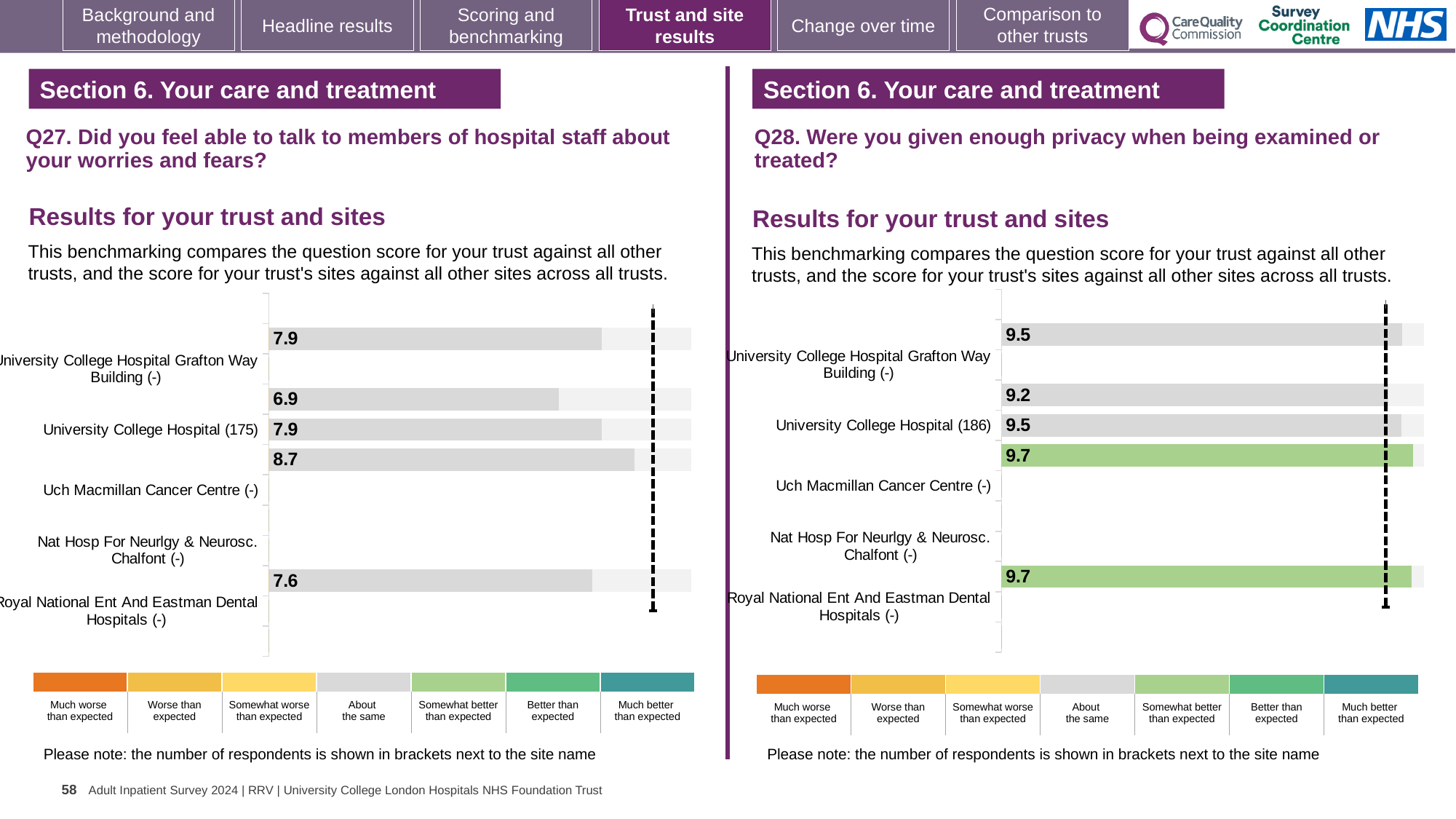
On the Q27 chart on the left, what is the highest value shown on any bar? 8.7 On the Q28 chart on the right, how many bars are plotted? 5 On the Q28 chart on the right, what is the value for University College Hospital (186)? 9.5 Which is larger: the value for University College Hospital on the Q27 chart (7.9) or on the Q28 chart (9.5)? Q28 chart (9.5) On the Q27 chart on the left, what is the lowest value shown on any bar? 6.9 On the Q27 chart on the left, what is the value for University College Hospital (175)? 7.9 What type of chart is used on the Q27 chart on the left? Bar chart How many respondents are shown in brackets for University College Hospital on the Q28 chart on the right? 186 On the Q28 chart on the right, what colour are the bars labelled 9.7? Green On the Q28 chart on the right, what is the highest value shown on any bar? 9.7 On the Q28 chart on the right, what is the lowest value shown on any bar? 9.2 On the Q27 chart on the left, what is the difference between the highest bar value (8.7) and the lowest bar value (6.9)? 1.8